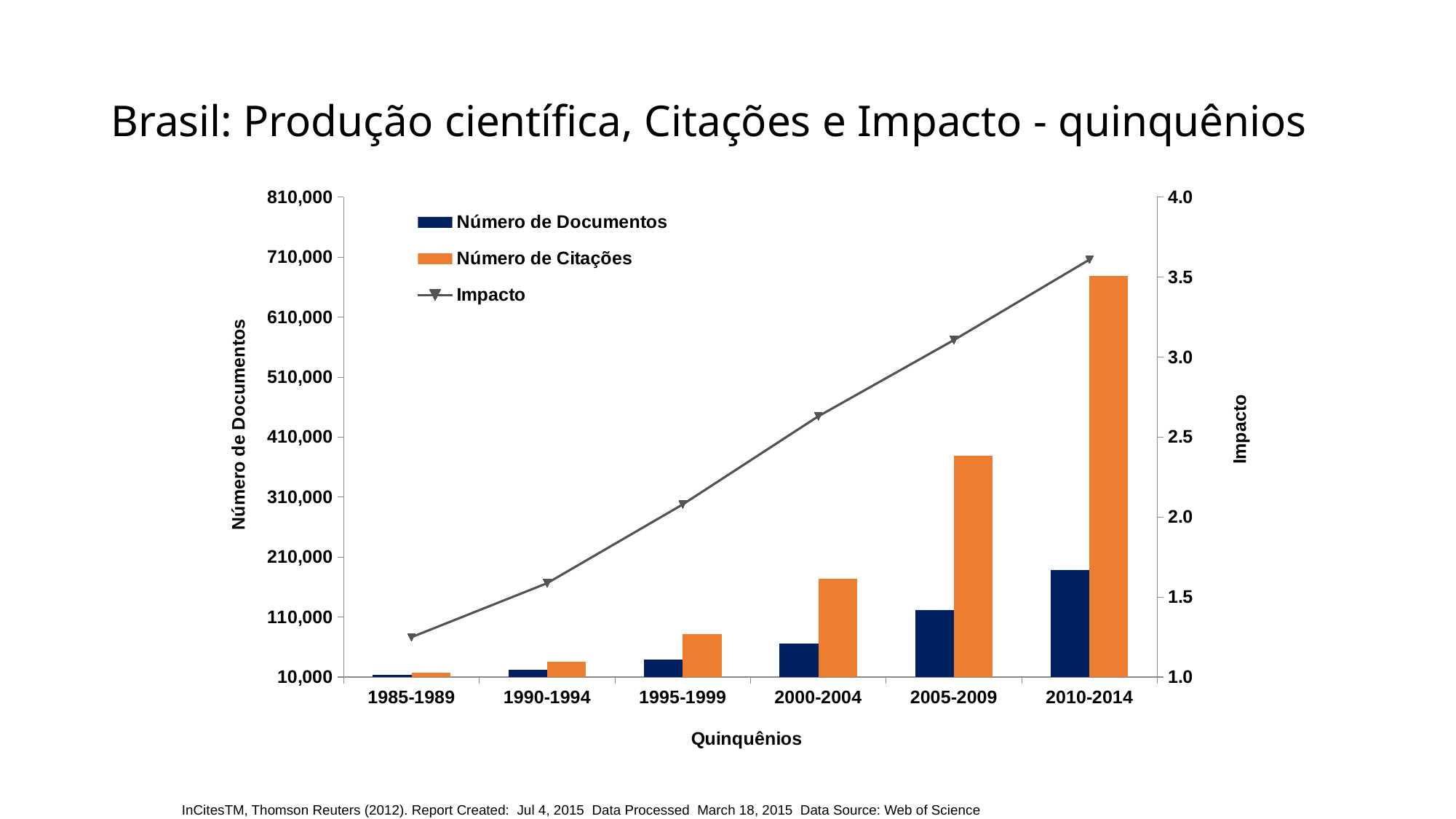
Does the Impacto line rise or fall from 1985-1989 to 2010-2014? Rises Which quinquênio has the lowest Número de Documentos? 1985-1989 Is the Impacto value for 1985-1989 greater or less than 1.5? less Is the Impacto value for 2010-2014 greater or less than 3.0? greater How many series does the legend list? 3 How many quinquênios (five-year periods) are shown on the x axis? 6 For 2005-2009, which is larger: Número de Documentos or Número de Citações? Número de Citações Is the Número de Citações for 2010-2014 greater or less than 610,000? greater What colour are the bars for Número de Citações? Orange What kind of chart is shown on the slide? A combined bar and line chart Which quinquênio has the highest Número de Citações? 2010-2014